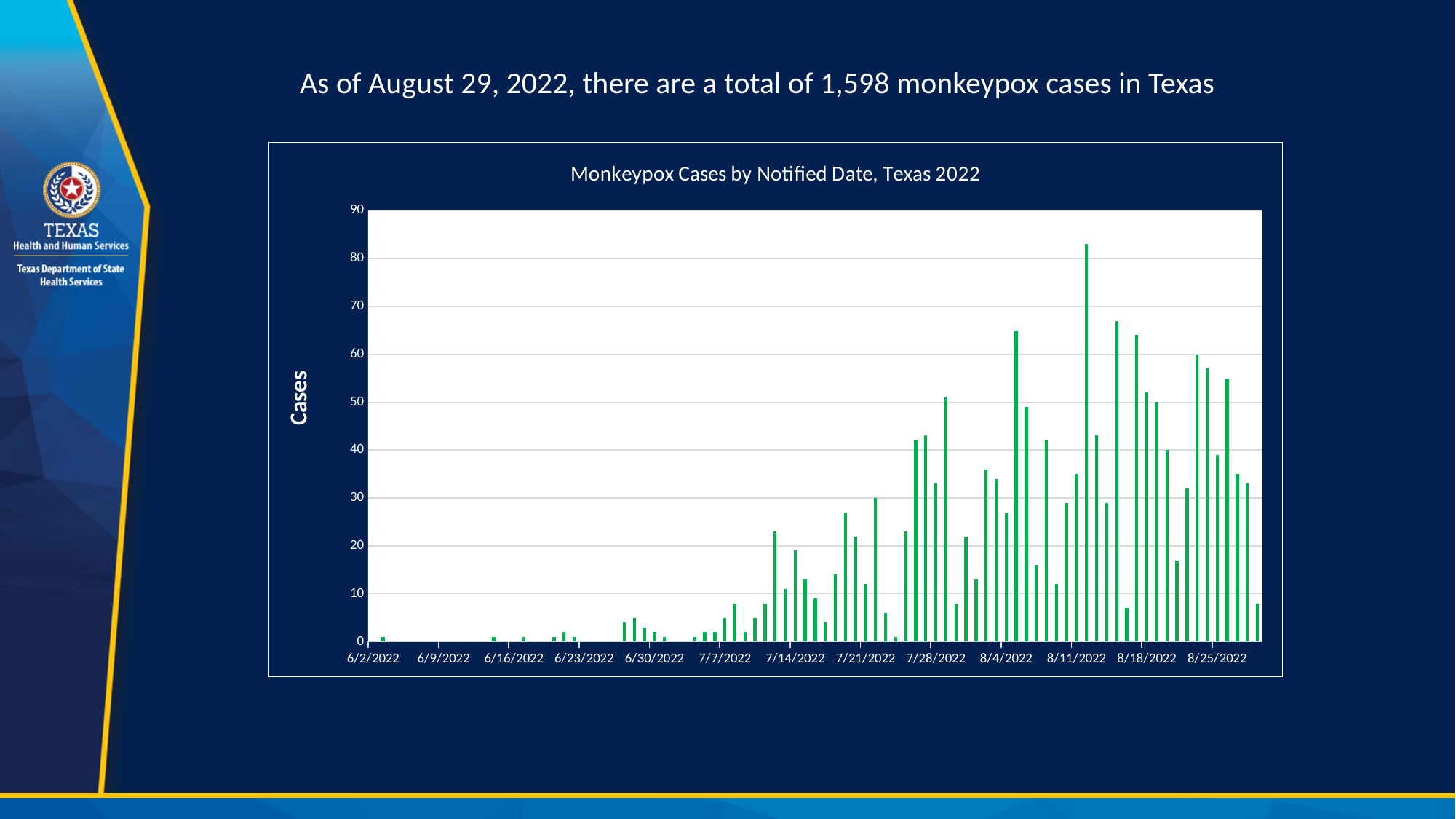
Is the tallest bar in the chart greater or less than 90? less What is the label on the vertical axis of the chart? Cases Is the tallest bar in the chart greater or less than 80? greater What type of chart is shown on the slide? bar chart What is the highest value shown on the vertical axis? 90 What is the first date label shown on the x axis? 6/2/2022 Overall, do the daily case counts rise or fall from June to August along the x axis? rise Is the value for 6/9/2022 greater or less than 10? less What is the title of the chart? Monkeypox Cases by Notified Date, Texas 2022 How many data series are plotted in the chart? 1 Which month has the tallest bar in the chart: June or August? August